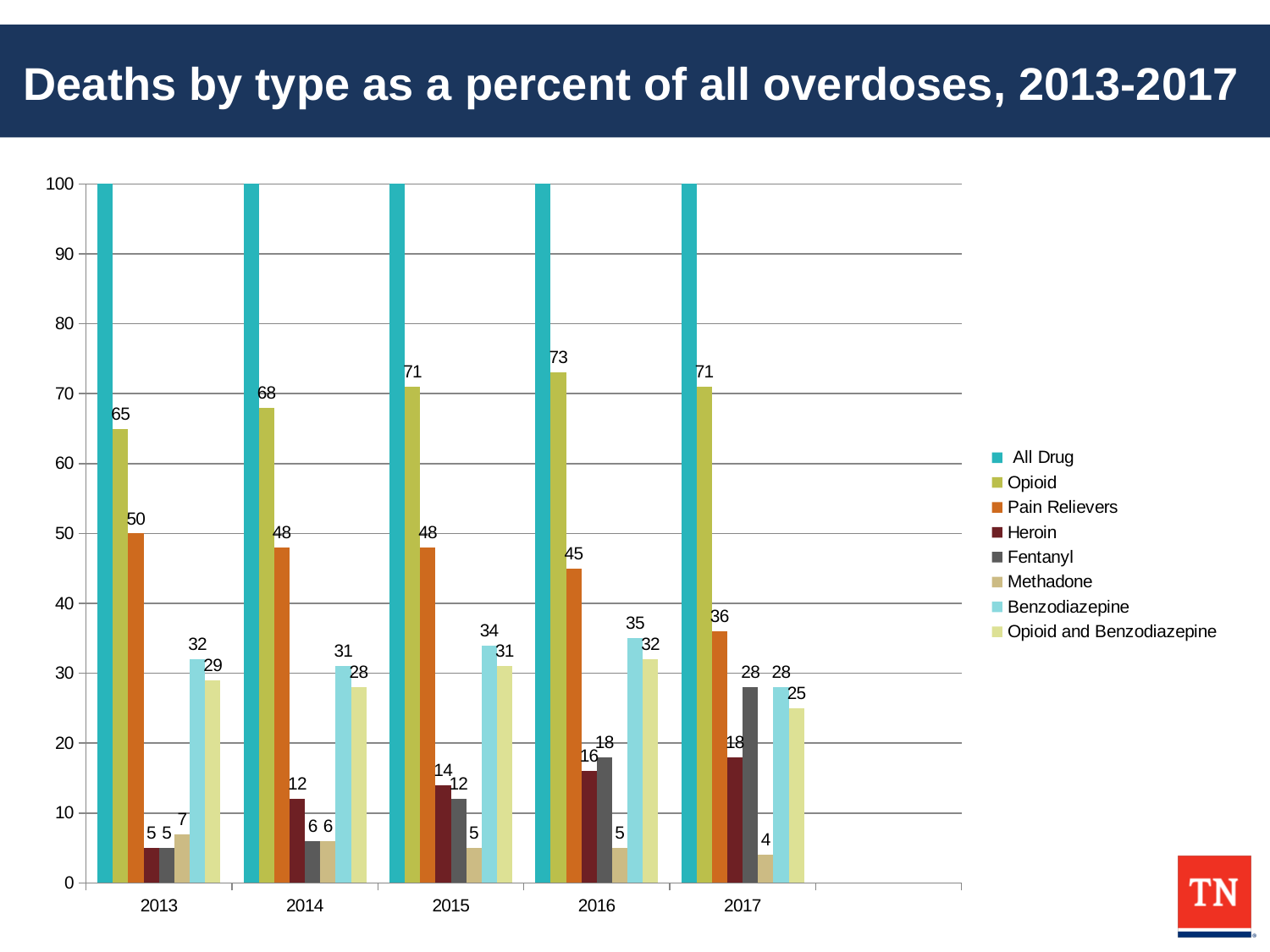
What is the Pain Relievers value for 2017? 36 What is the Opioid value for 2016? 73 In which year is the Methadone value lowest? 2017 Does the Fentanyl value rise or fall from 2013 to 2017? Rise How many years are shown on the x axis? 5 What is the difference between the Pain Relievers values for 2013 and 2017? 14 Is the All Drug value for 2014 greater or less than 90? greater Which is larger in 2017, the Heroin value or the Fentanyl value? Fentanyl In which year is the Opioid value highest? 2016 How many series does the legend list? 8 What is the Fentanyl value for 2015? 12 What kind of chart is shown on the slide? Bar chart